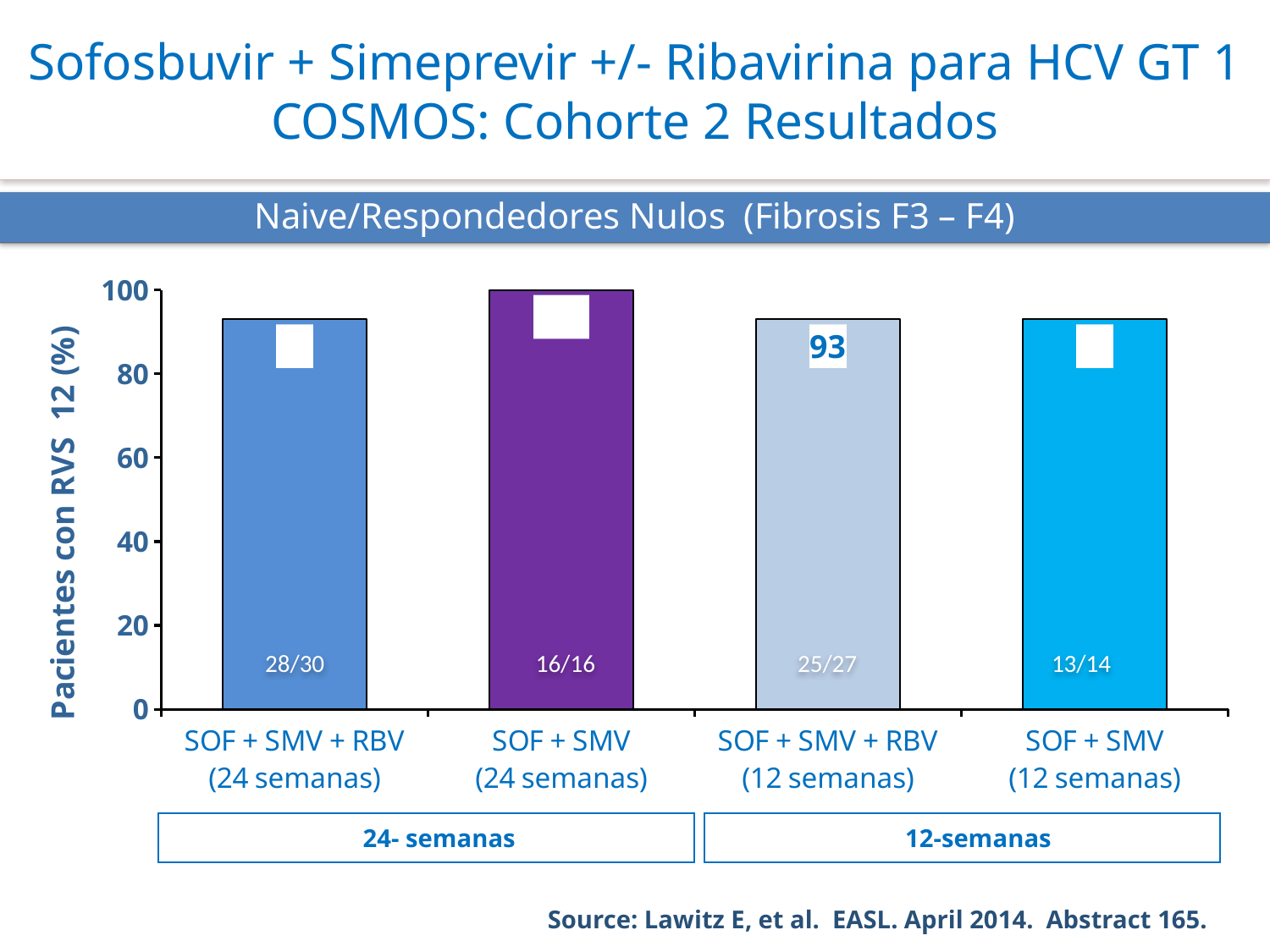
What fraction of patients is shown on the bar for SOF + SMV (24 semanas)? 16/16 What type of chart is shown on the slide? bar chart Is the value for SOF + SMV + RBV (24 semanas) greater or less than 80? greater What fraction of patients is shown on the bar for SOF + SMV + RBV (24 semanas)? 28/30 What is the RVS 12 value for SOF + SMV + RBV (12 semanas)? 93 Which treatment arm has the highest RVS 12 rate? SOF + SMV (24 semanas) What is the difference between the value for SOF + SMV (24 semanas) and the value for SOF + SMV + RBV (12 semanas)? 7 What is the label on the y axis of the chart? Pacientes con RVS 12 (%) What fraction of patients is shown on the bar for SOF + SMV (12 semanas)? 13/14 Which is larger, the value for SOF + SMV (24 semanas) or the value for SOF + SMV + RBV (12 semanas)? SOF + SMV (24 semanas) How many bars are plotted in the chart? 4 What is the RVS 12 value for SOF + SMV (24 semanas)? 100